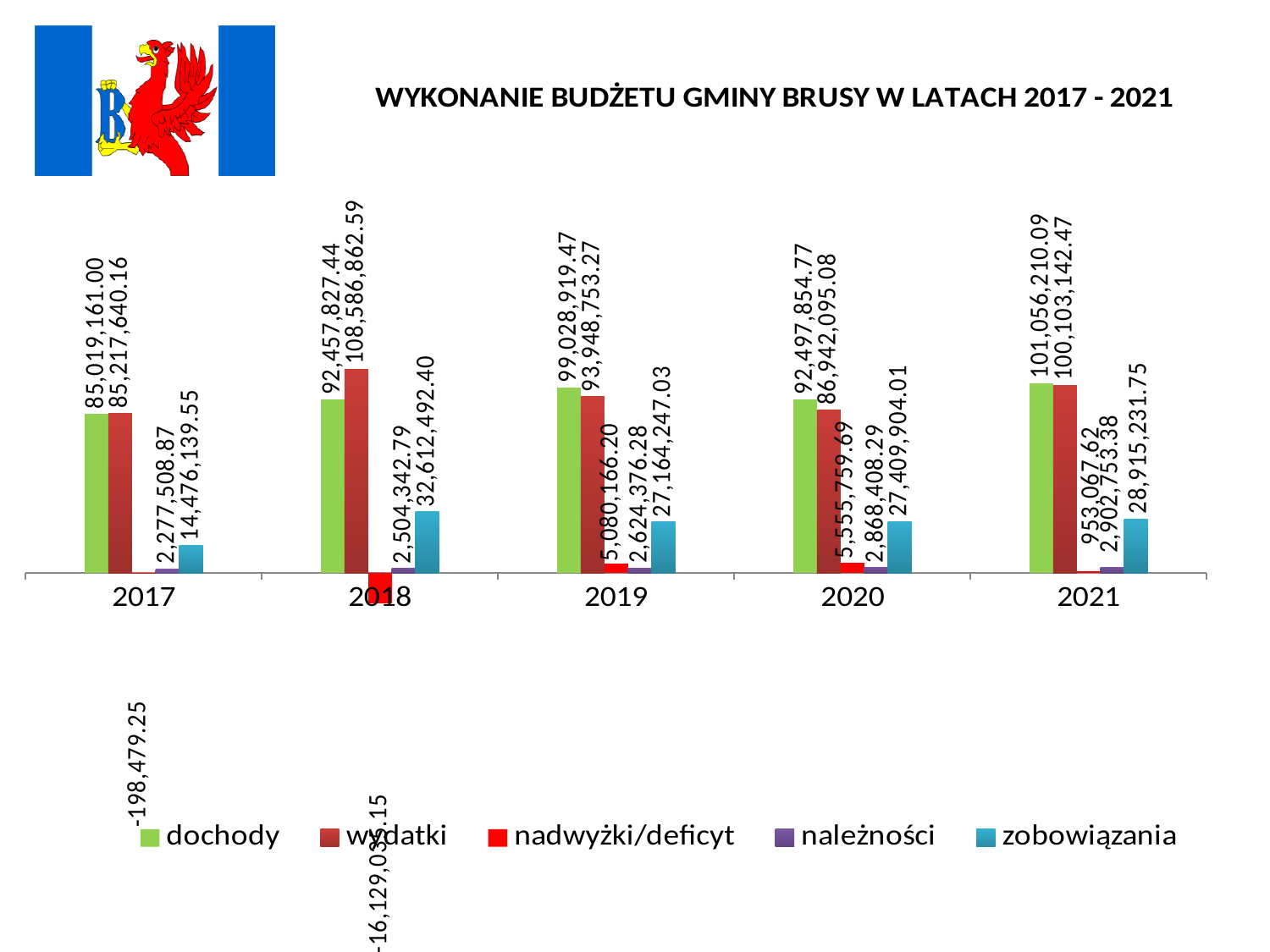
In which year is dochody the highest? 2021 In which year is należności the lowest? 2017 How many years are shown on the x axis? 5 What is the value of nadwyżki/deficyt for 2017? -198,479.25 In 2020, which is larger: dochody or wydatki? dochody What is the difference between dochody and wydatki in 2019? 5,080,166.20 How many series does the legend list? 5 What is the value of zobowiązania for 2017? 14,476,139.55 What kind of chart is shown on the slide? bar chart What is the value of dochody for 2021? 101,056,210.09 In which year is zobowiązania the highest? 2018 What is the value of wydatki for 2018? 108,586,862.59